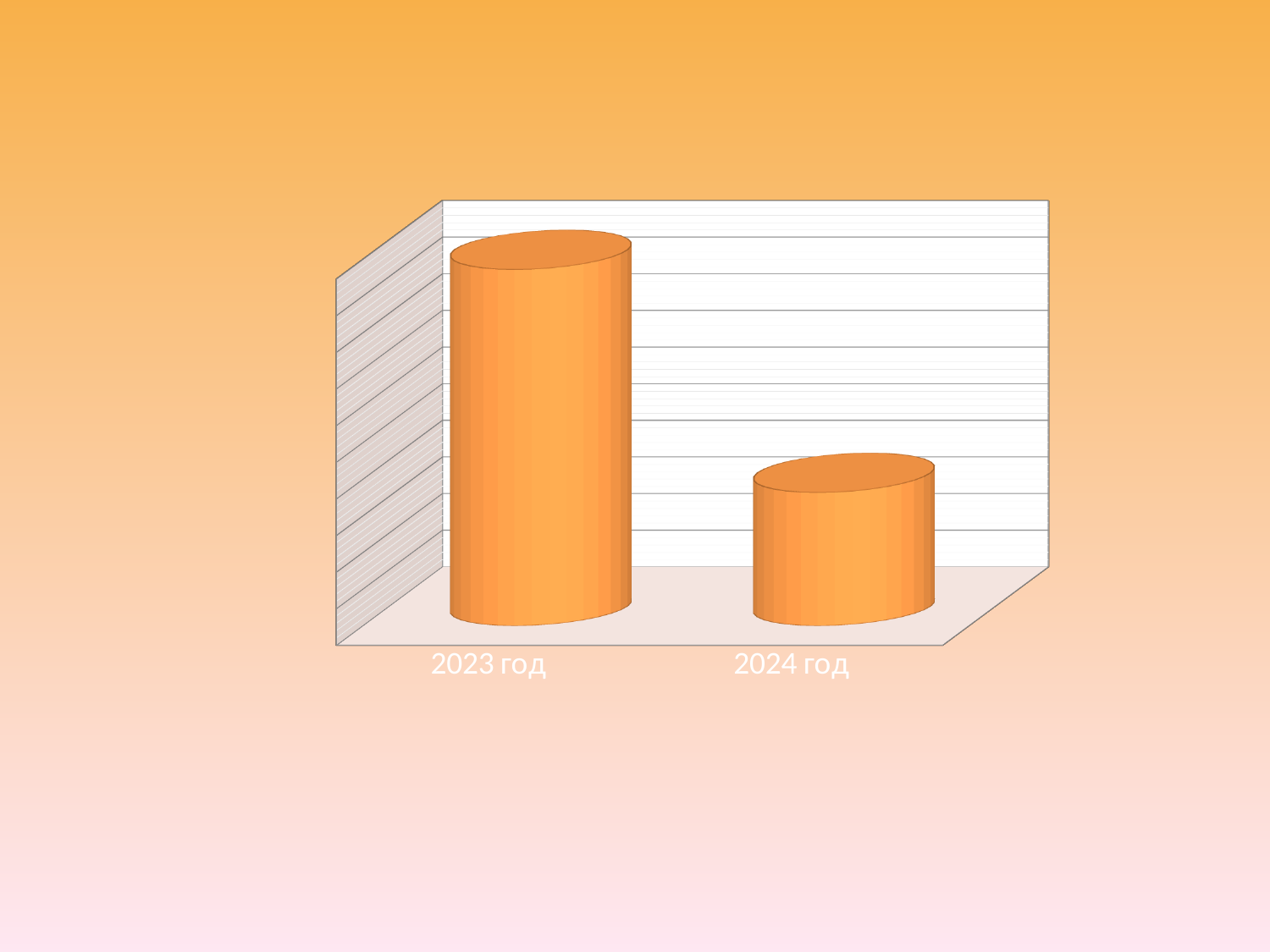
What colour are the bars on the chart? orange What kind of chart is shown on the slide? bar chart How many categories are plotted on the chart? 2 What are the category labels shown on the x axis of the chart? 2023 год, 2024 год Which category has the highest value on the chart? 2023 год Do the values rise or fall from 2023 год to 2024 год? fall Which is larger, the value for 2023 год or the value for 2024 год? 2023 год Which category has the lowest value on the chart? 2024 год